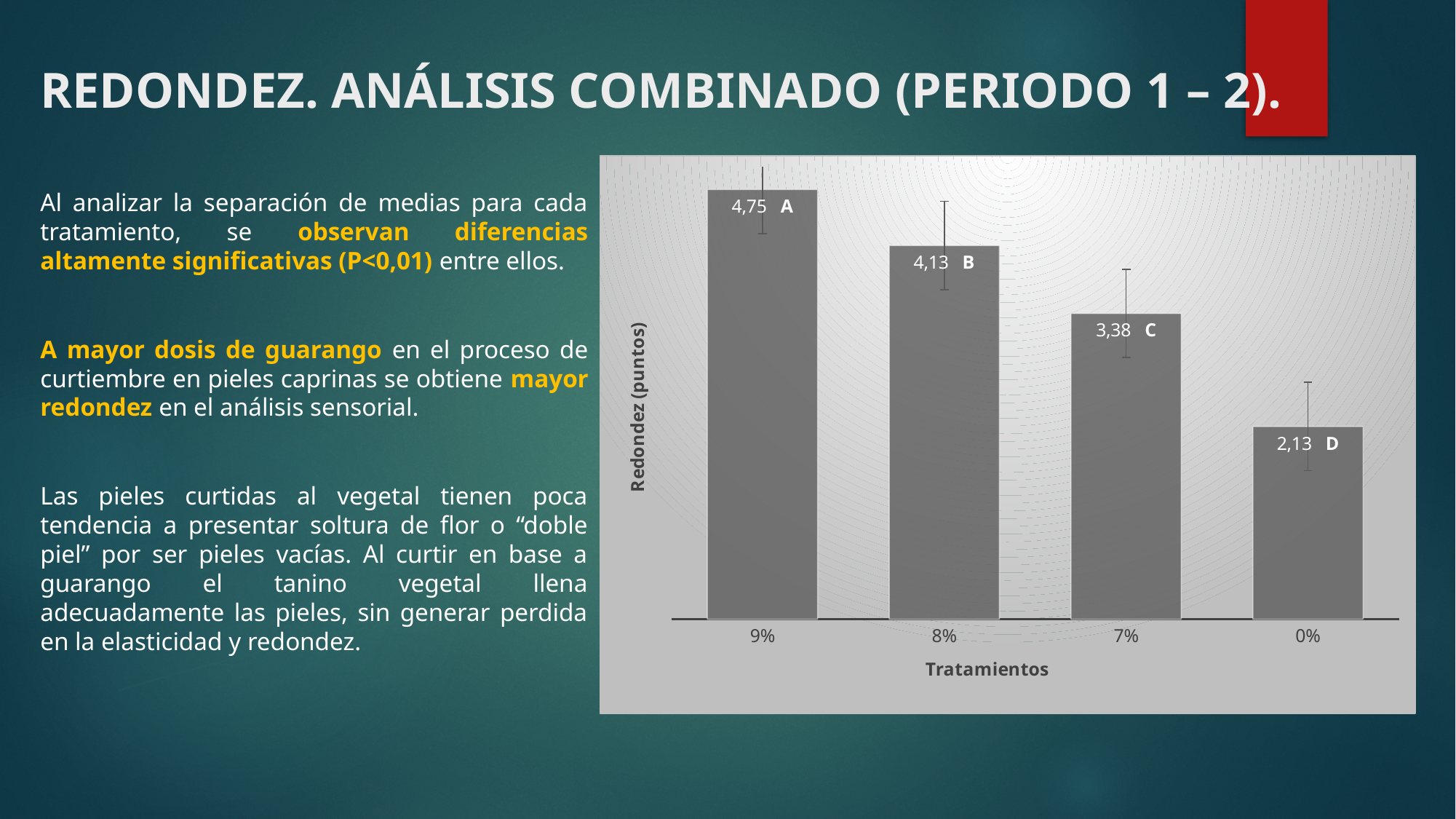
What is the Redondez value for the 8% treatment? 4,13 What is the Redondez value for the 0% treatment? 2,13 What kind of chart is shown on the slide? Bar chart What is the Redondez value for the 7% treatment? 3,38 How many treatments are shown on the x axis of the chart? 4 Which treatment has the highest Redondez value? 9% What is the difference between the Redondez values for the 8% and 7% treatments? 0,75 What is the difference between the Redondez values for the 9% and 0% treatments? 2,62 What is the Redondez value for the 9% treatment? 4,75 Which treatment has a larger Redondez value, 8% or 7%? 8% What is the label of the y axis of the chart? Redondez (puntos) Which treatment has the lowest Redondez value? 0%